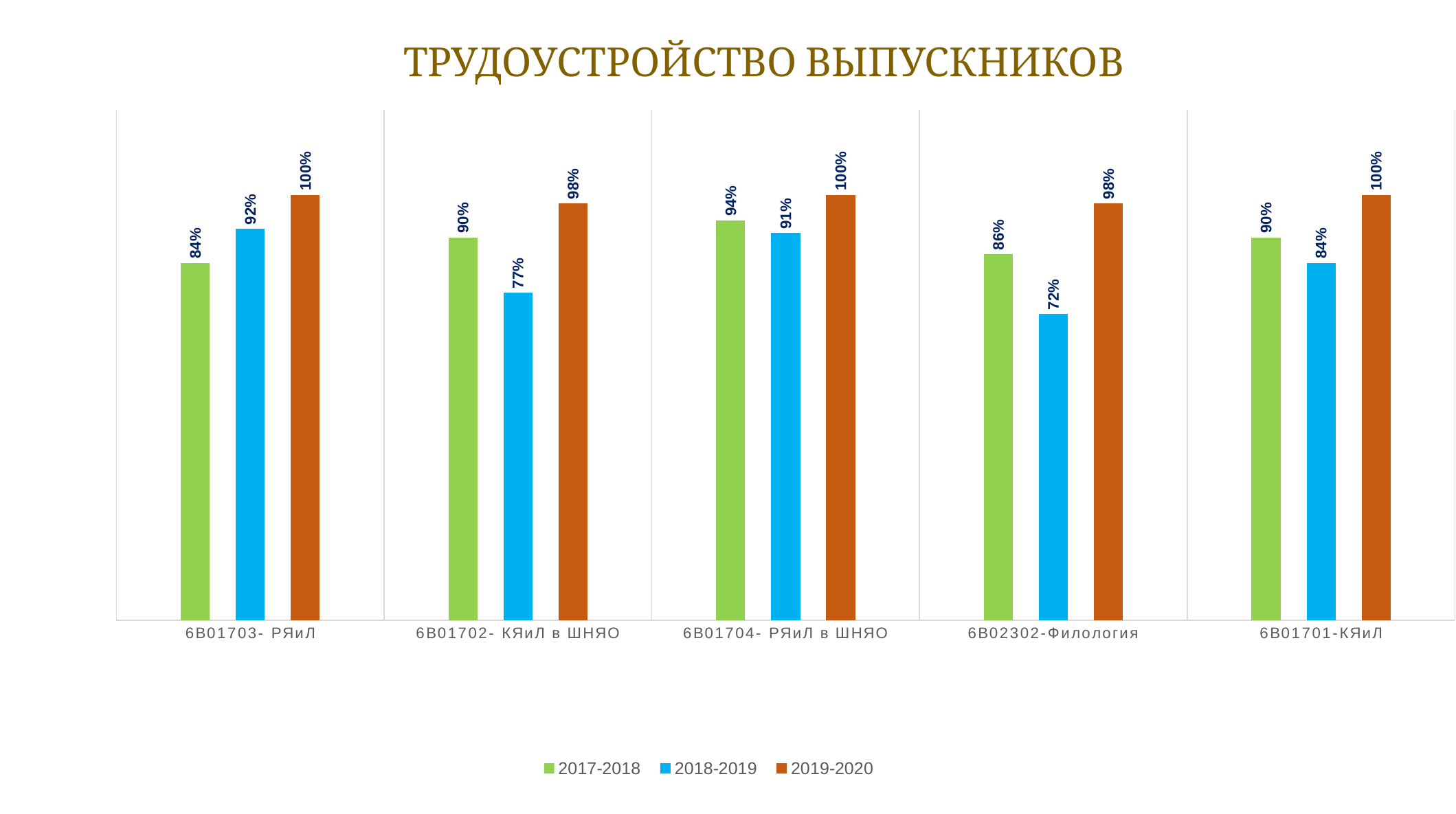
What is the value for 6B01704- РЯиЛ в ШНЯО in the 2017-2018 series? 94% Which category has the highest value in the 2017-2018 series? 6B01704- РЯиЛ в ШНЯО What is the difference between the 2019-2020 and 2018-2019 values for 6B01702- КЯиЛ в ШНЯО? 21% What is the title of the chart? ТРУДОУСТРОЙСТВО ВЫПУСКНИКОВ What is the value for 6B01702- КЯиЛ в ШНЯО in the 2019-2020 series? 98% What kind of chart is shown on the slide? Bar chart Which category has the lowest value in the 2018-2019 series? 6B02302-Филология How many categories are shown on the x axis? 5 What is the value for 6B01703- РЯиЛ in the 2018-2019 series? 92% Which is larger for 6B01701-КЯиЛ: the 2017-2018 value or the 2018-2019 value? 2017-2018 How many series does the legend list? 3 What is the value for 6B02302-Филология in the 2018-2019 series? 72%